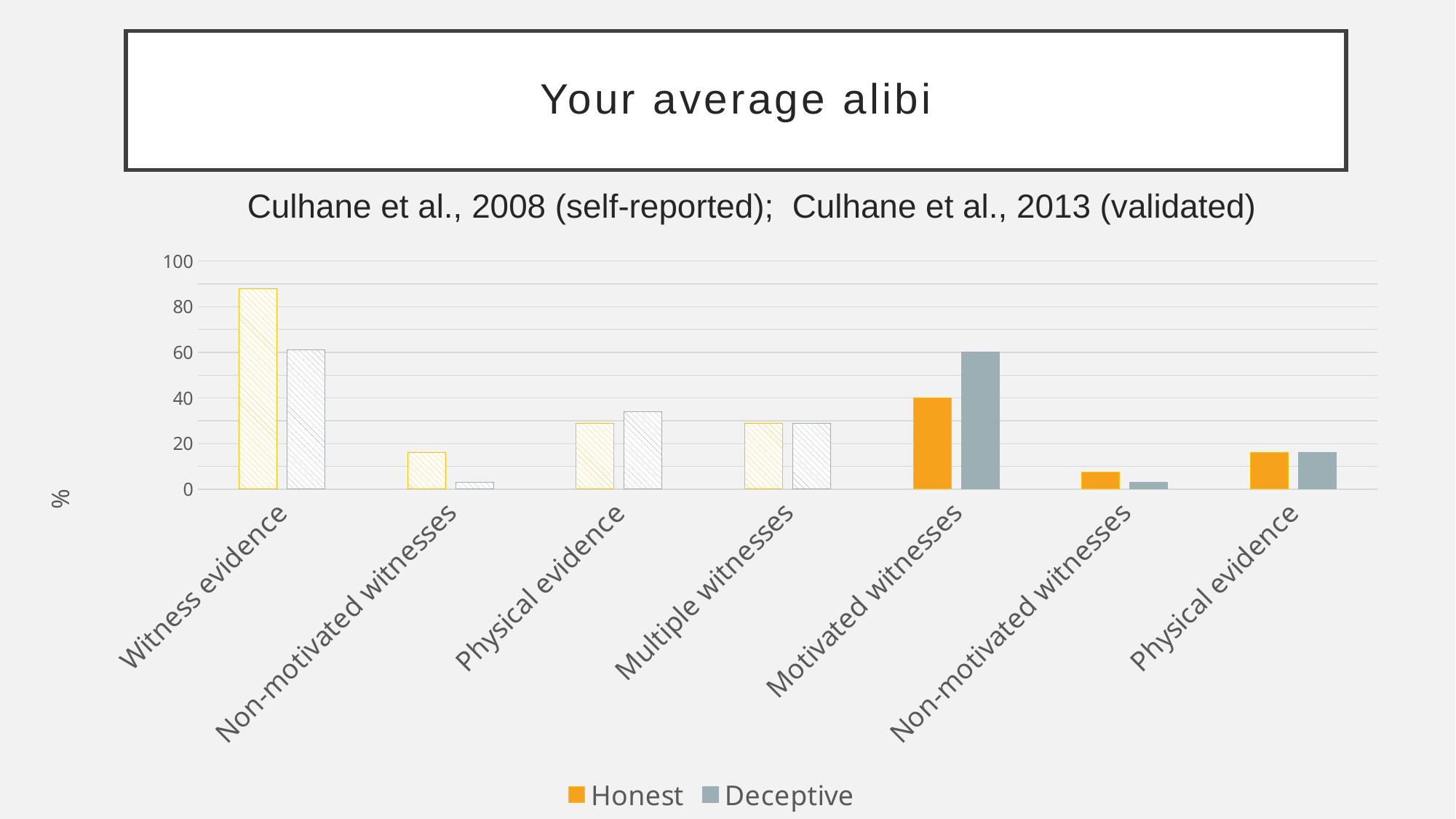
Which category has the tallest bar in the chart? Witness evidence Is the Deceptive value for Witness evidence greater or less than 80? less Is the Honest value for Multiple witnesses greater or less than 40? less Is the Deceptive value for the first Non-motivated witnesses category (left side of the chart) greater or less than 20? less What are the two series named in the legend? Honest and Deceptive What kind of chart is shown on the slide? bar chart For Witness evidence, which is larger, the Honest bar or the Deceptive bar? Honest How many series does the legend list? 2 For Motivated witnesses, which is larger, the Honest bar or the Deceptive bar? Deceptive How many categories are shown along the x axis? 7 What label is shown on the vertical axis of the chart? %